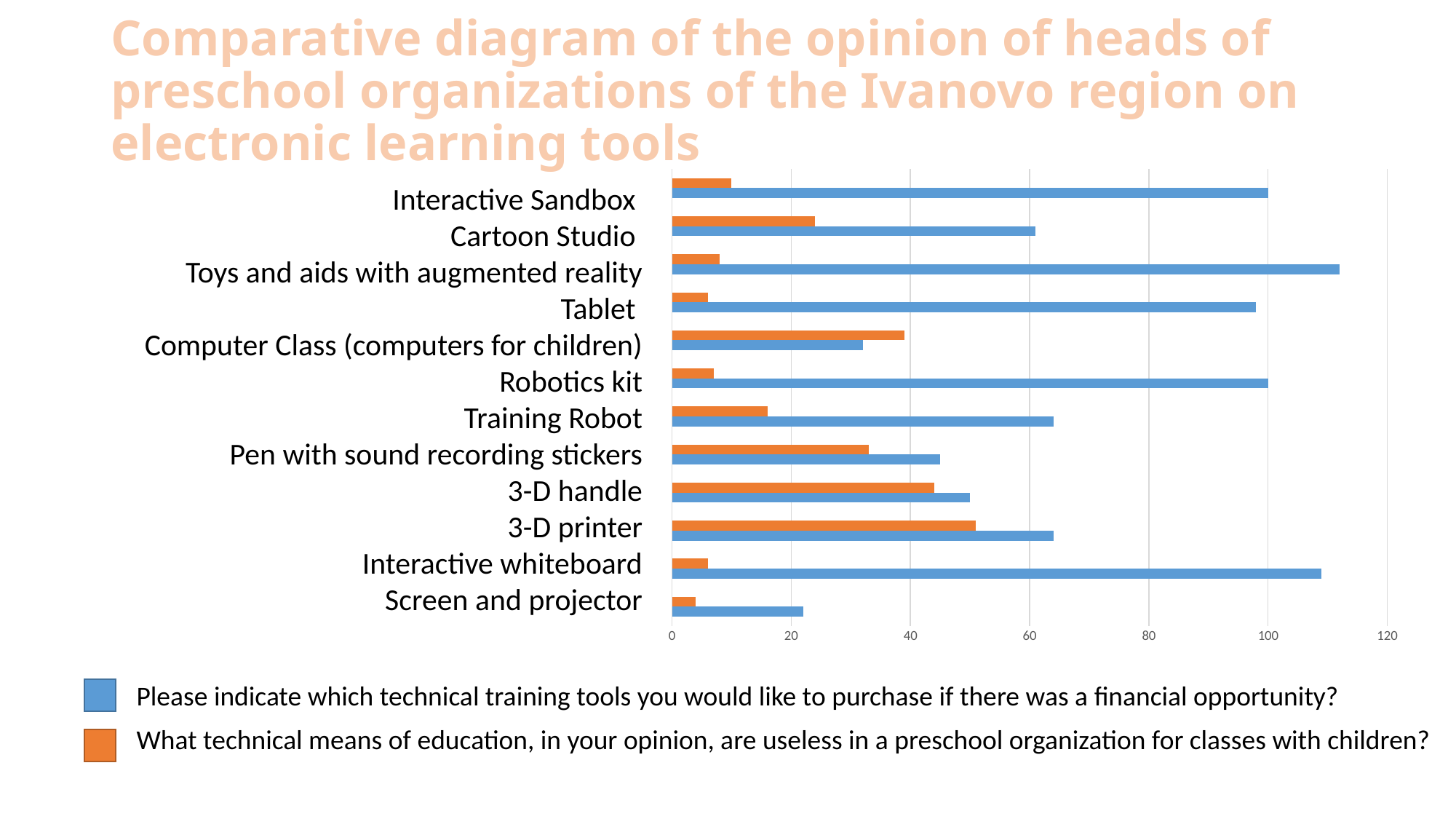
What kind of chart is shown on the slide? bar chart For Computer Class (computers for children), which series has the larger value, blue or orange? orange Is the orange-series value for Pen with sound recording stickers greater or less than 20? greater Which category has the highest value for the orange series (tools considered useless)? 3-D printer Is the blue-series value for Interactive Sandbox greater or less than 80? greater Is the blue-series value for Computer Class (computers for children) greater or less than 40? less Which colour represents the question about tools considered useless in a preschool organization? orange How many series does the legend list? 2 Which has the larger blue-series value, Tablet or Cartoon Studio? Tablet How many categories (learning tools) are listed on the chart? 12 Which category has the lowest value for the blue series (tools they would like to purchase)? Screen and projector